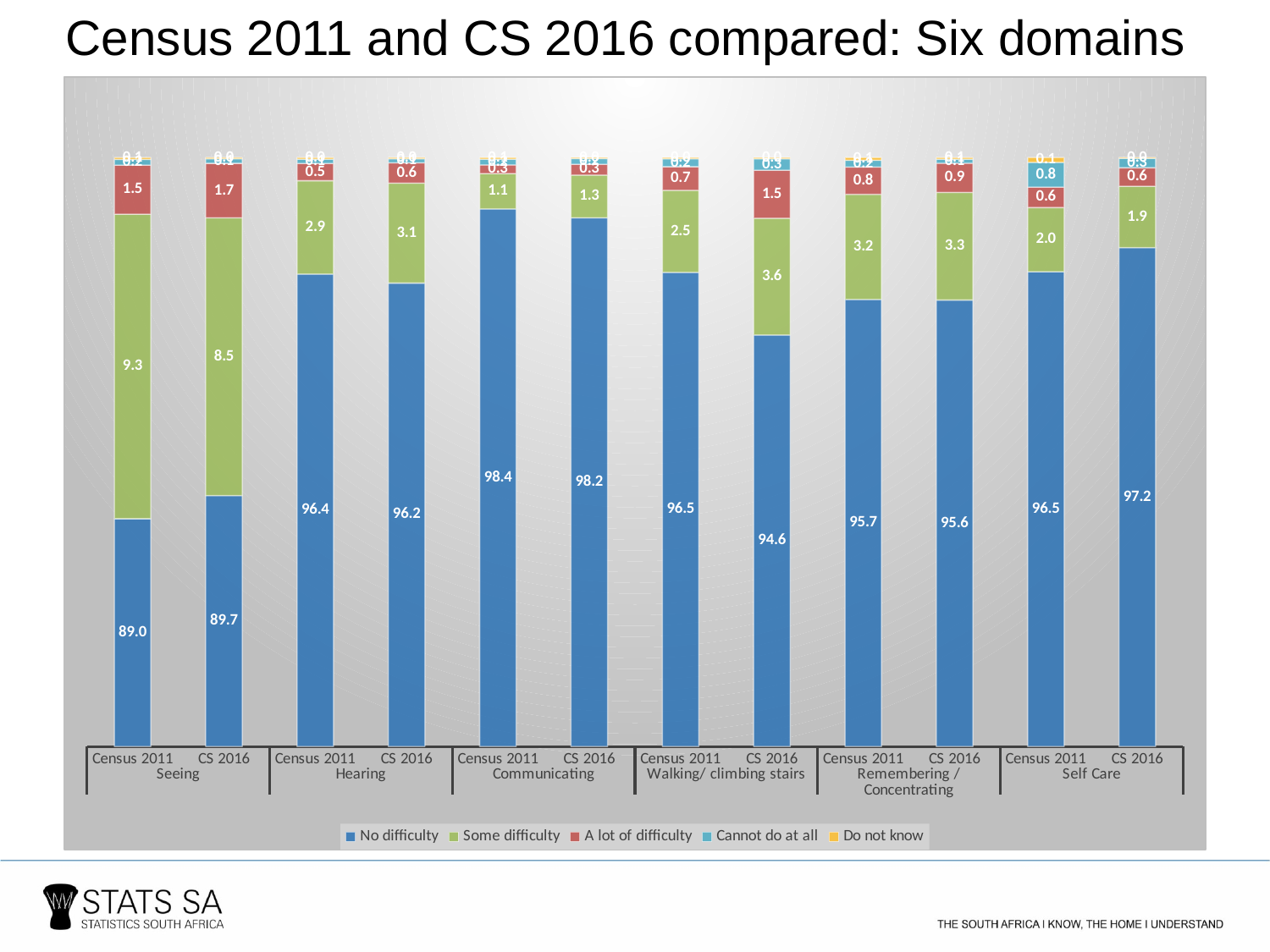
How many series does the legend list? 5 How many domains are shown on the x axis? 6 What kind of chart is shown on the slide? Stacked bar chart Which domain and survey has the highest 'No difficulty' value? Communicating, Census 2011 Which domain and survey has the lowest 'No difficulty' value? Seeing, Census 2011 What is the difference between the 'Some difficulty' values for Census 2011 and CS 2016 in the Seeing domain? 0.8 What is the 'Some difficulty' value for CS 2016 in the Walking/ climbing stairs domain? 3.6 What is the 'No difficulty' value for Census 2011 in the Seeing domain? 89.0 Which is larger, the 'No difficulty' value for Census 2011 or CS 2016 in the Hearing domain? Census 2011 What is the 'A lot of difficulty' value for CS 2016 in the Seeing domain? 1.7 What is the 'No difficulty' value for CS 2016 in the Self Care domain? 97.2 What is the difference between the 'No difficulty' values for Census 2011 and CS 2016 in the Walking/ climbing stairs domain? 1.9